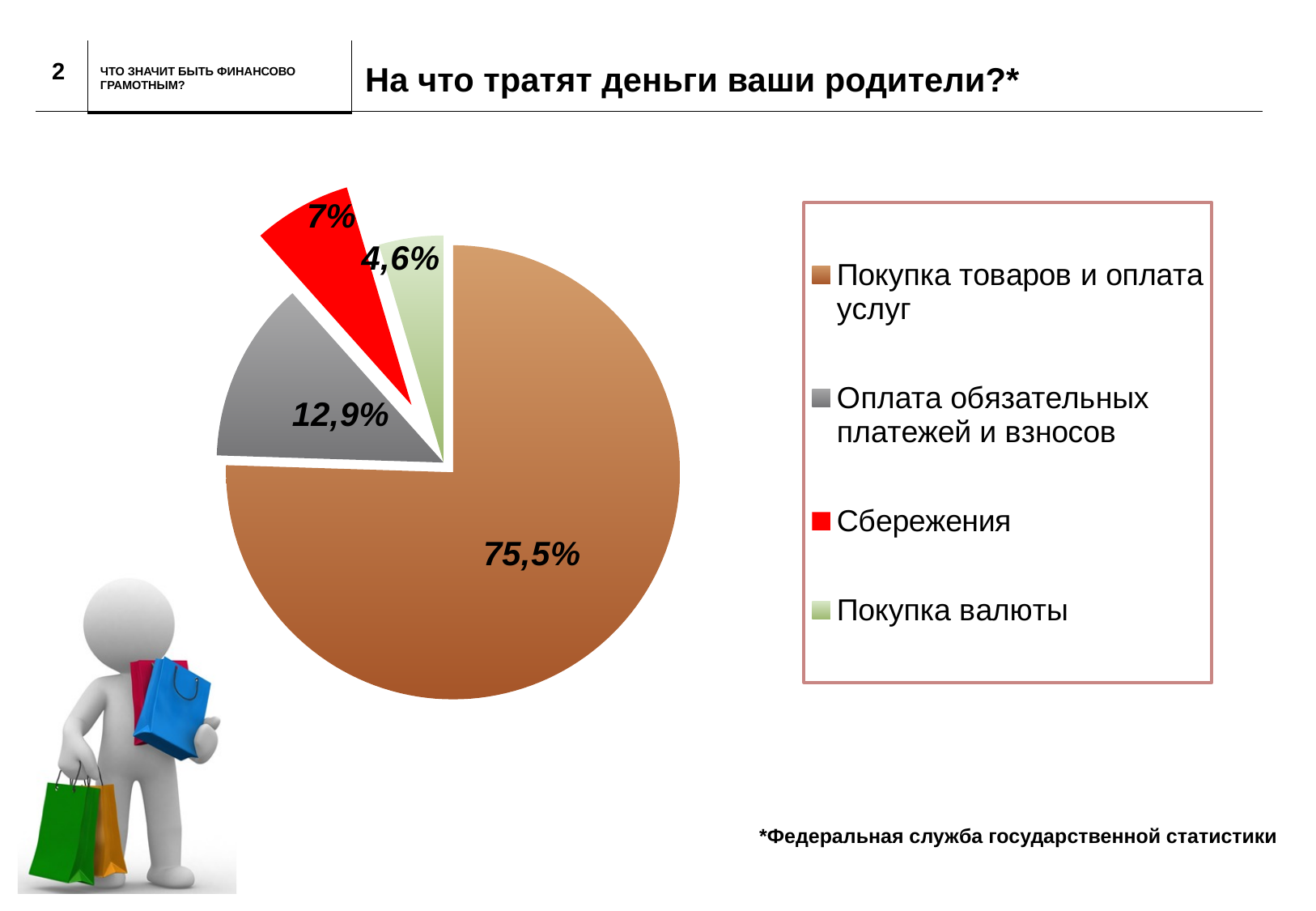
What share of the pie is labelled for Покупка валюты? 4,6% Which category has the smallest slice of the pie? Покупка валюты What colour is the slice for Сбережения? red What kind of chart is shown on the slide? pie chart How many slices does the pie chart have? 4 Which is larger: the slice for Сбережения or the slice for Покупка валюты? Сбережения Which category has the largest slice of the pie? Покупка товаров и оплата услуг What is the difference between the shares for Оплата обязательных платежей и взносов and Сбережения? 5,9% What share of the pie is labelled for Оплата обязательных платежей и взносов? 12,9% What is the title of the chart on the slide? На что тратят деньги ваши родители?* What share of the pie is labelled for Покупка товаров и оплата услуг? 75,5% What share of the pie is labelled for Сбережения? 7%